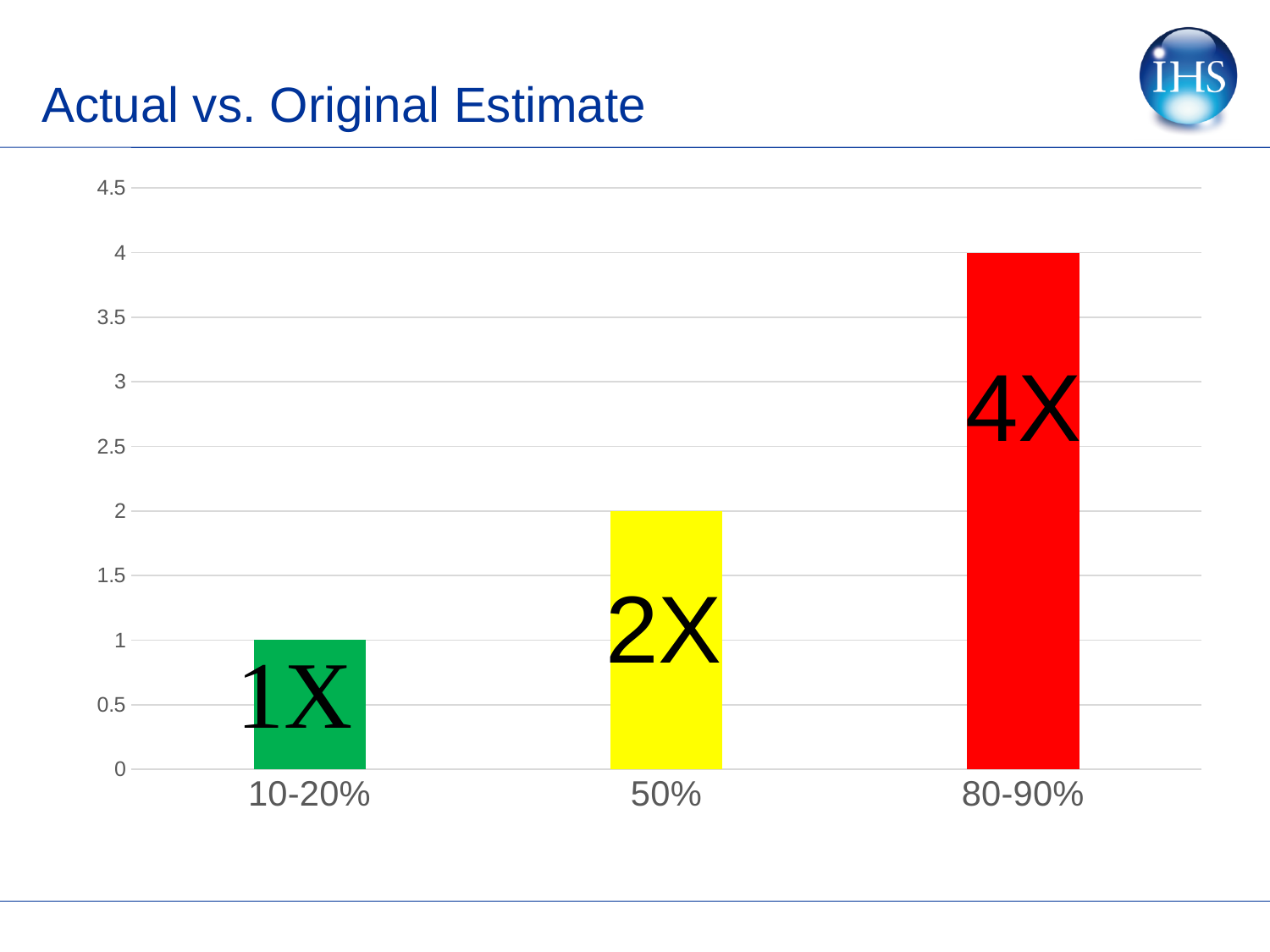
What is the difference between the values for 80-90% and 50%? 2 What label is printed on the bar for the 80-90% category? 4X Which category has the highest bar? 80-90% What label is printed on the bar for the 50% category? 2X What value on the y axis does the bar for 10-20% reach? 1 Do the bar values rise or fall from left to right along the x axis? rise What value on the y axis does the bar for 80-90% reach? 4 Which category has the lowest bar? 10-20% How many bars are plotted in the chart? 3 Which is larger, the value for 50% or the value for 10-20%? 50% What type of chart is shown on the slide? bar chart What is the title of the slide containing the chart? Actual vs. Original Estimate